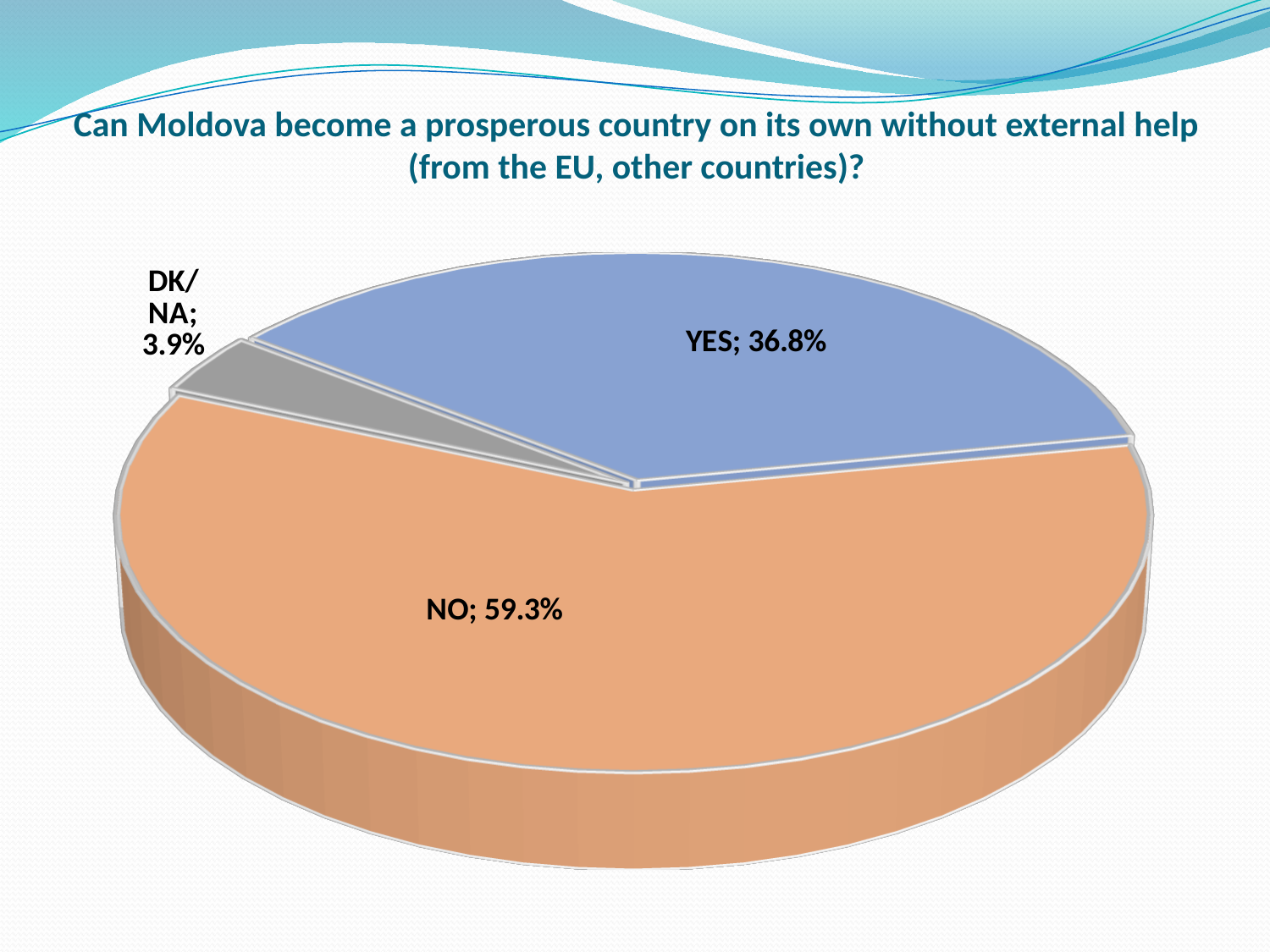
How many slices does the pie chart have? 3 What percentage of respondents answered YES? 36.8% What percentage of respondents answered NO? 59.3% What question does the chart title ask? Can Moldova become a prosperous country on its own without external help (from the EU, other countries)? Which is larger, the YES share or the NO share? NO What kind of chart is shown on the slide? Pie chart What is the value shown for the DK/NA slice? 3.9% Which response has the largest share of the pie? NO What is the difference in percentage points between the YES and DK/NA shares? 32.9 What is the difference in percentage points between the NO and YES shares? 22.5 Which response has the smallest share of the pie? DK/NA What colour is the NO slice of the pie? Orange